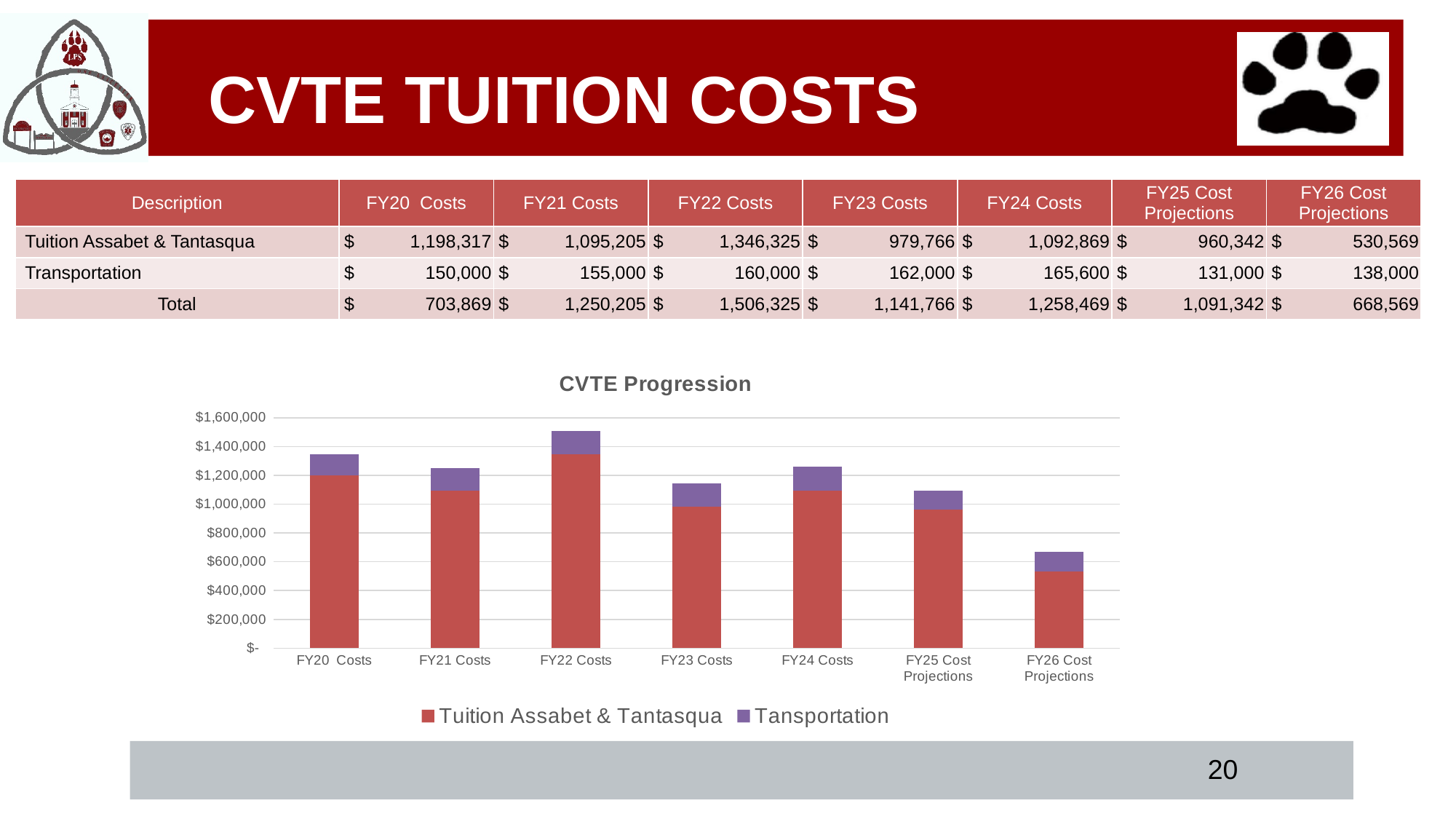
How many fiscal-year categories are shown on the x axis of the CVTE Progression chart? 7 Which fiscal year has the tallest stacked bar in the CVTE Progression chart? FY22 Costs How many series does the legend of the CVTE Progression chart list? 2 Which fiscal year has the shortest stacked bar in the CVTE Progression chart? FY26 Cost Projections In the CVTE Progression chart, is the Tuition Assabet & Tantasqua bar larger for FY22 Costs or FY23 Costs? FY22 Costs Which series is shown in purple in the CVTE Progression chart? Tansportation In the CVTE Progression chart, is the Tuition Assabet & Tantasqua value for FY23 Costs greater or less than $1,000,000? less Do the stacked bar totals in the CVTE Progression chart rise or fall from FY24 Costs to FY26 Cost Projections? fall What is the Tuition Assabet & Tantasqua value for FY22 Costs, as shown in the table? $1,346,325 In the CVTE Progression chart, is the total stacked bar for FY26 Cost Projections greater or less than $800,000? less What kind of chart is the CVTE Progression chart? Stacked bar chart What is the total of the FY22 Costs stacked bar (Tuition plus Transportation), as shown in the table? $1,506,325